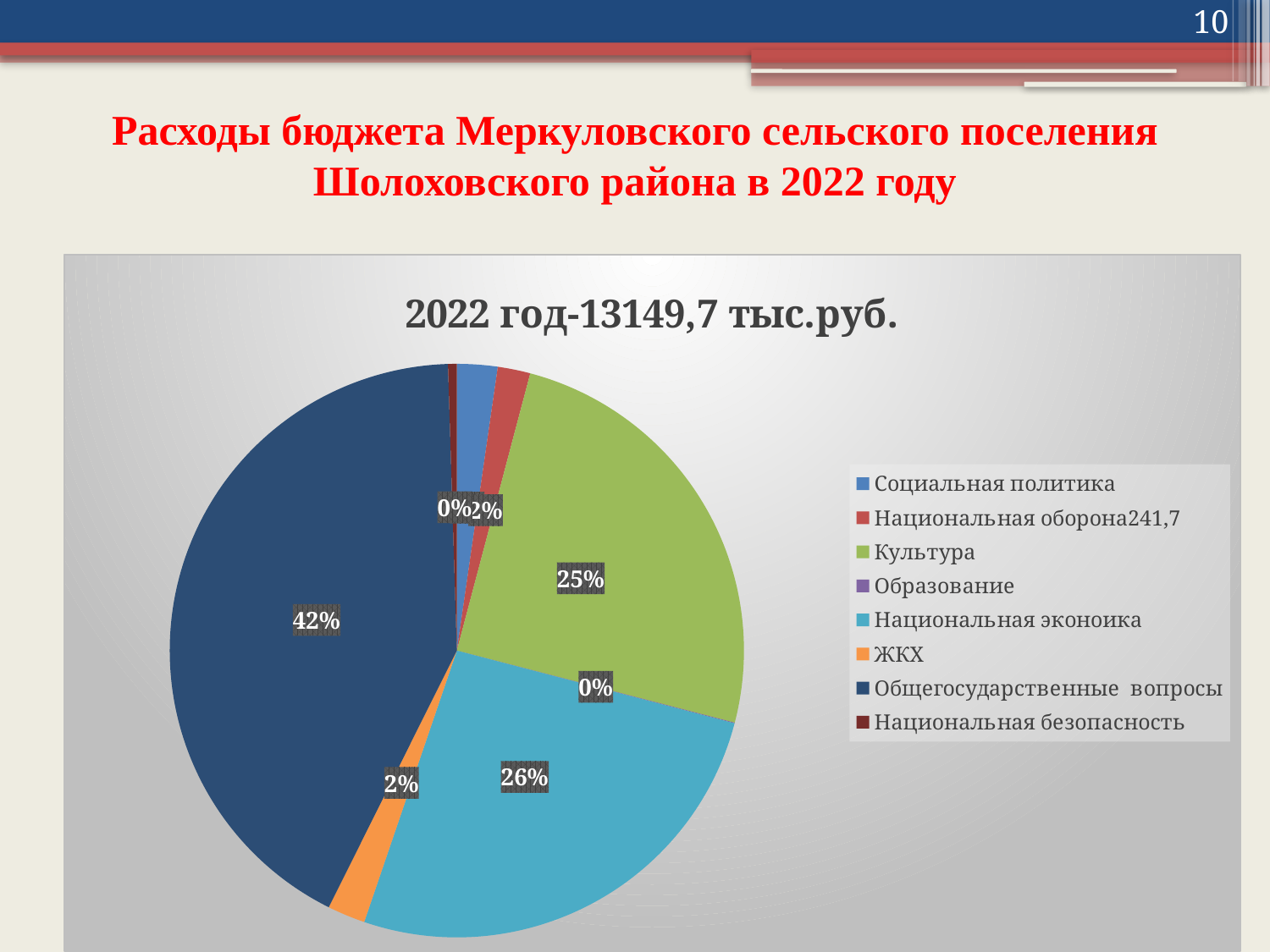
What share of the pie does Общегосударственные вопросы have? 42% What kind of chart is shown on the slide? pie chart What share of the pie does Национальная эконоика have? 26% What is the difference in percentage points between the shares of Общегосударственные вопросы and Национальная эконоика? 16 What share of the pie does Образование have? 0% How many entries does the chart legend list? 8 What colour is the slice for Общегосударственные вопросы? dark blue What is the title of the chart? 2022 год-13149,7 тыс.руб. Which is larger, the share for Культура or the share for Национальная эконоика? Национальная эконоика Which category has the largest share of the pie? Общегосударственные вопросы